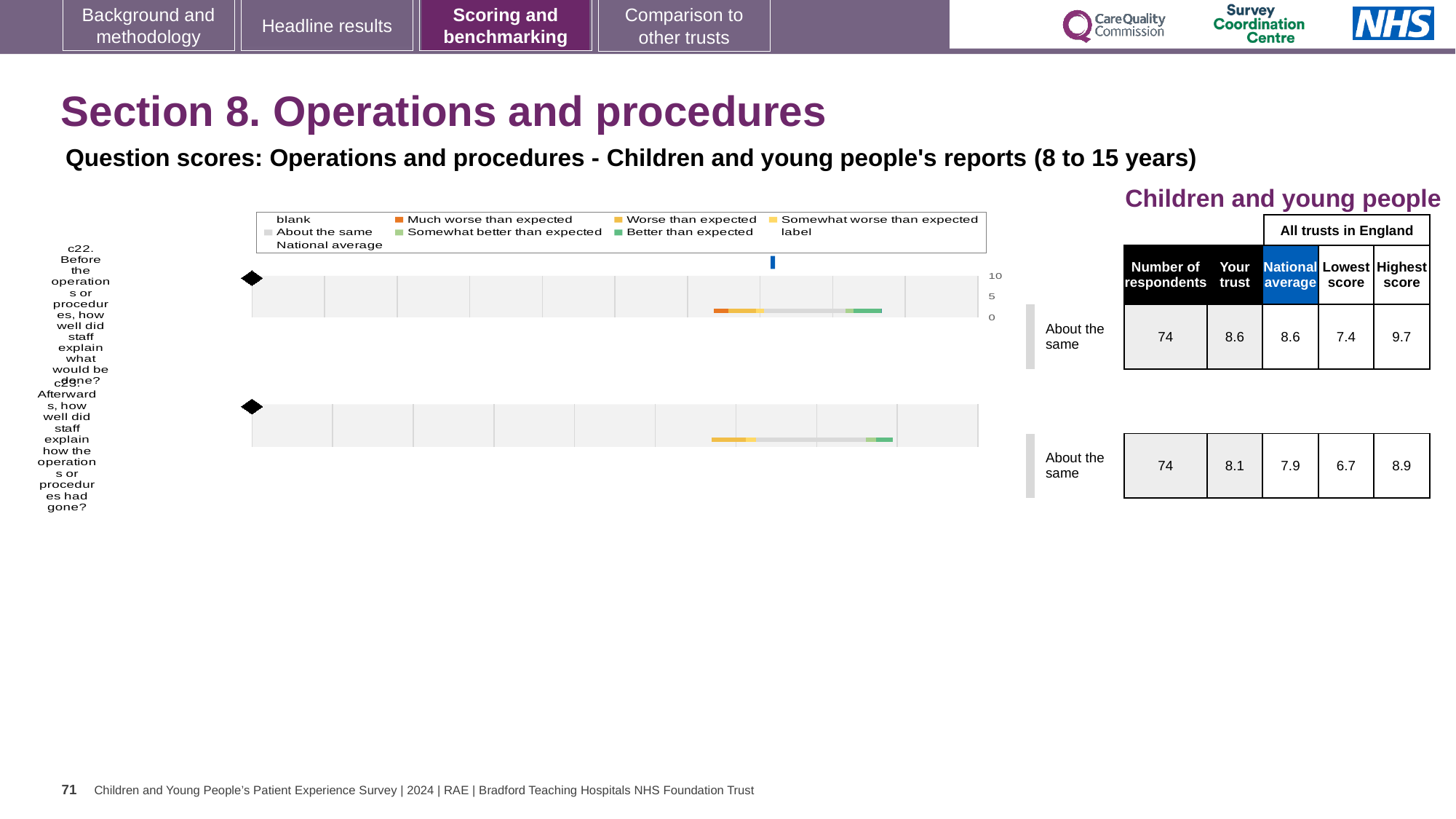
How many respondents answered c22? 74 What colour represents 'Much worse than expected' in the legend? orange What benchmark category is shown for c22? About the same For c23, what is the difference between the highest score and the lowest score among all trusts in England? 2.2 For c23, which is larger: the 'Your trust' score or the national average? Your trust For c23 (Afterwards, how well did staff explain how the operations or procedures had gone?), what is the 'Your trust' score? 8.1 How many entries does the chart legend list? 9 What kind of chart is used for the c22 and c23 question scores? bar chart How many question charts are shown on the slide? 2 For c23, what is the national average score? 7.9 For c22 (Before the operations or procedures, how well did staff explain what would be done?), what is the 'Your trust' score? 8.6 For c22, what is the highest score among all trusts in England? 9.7